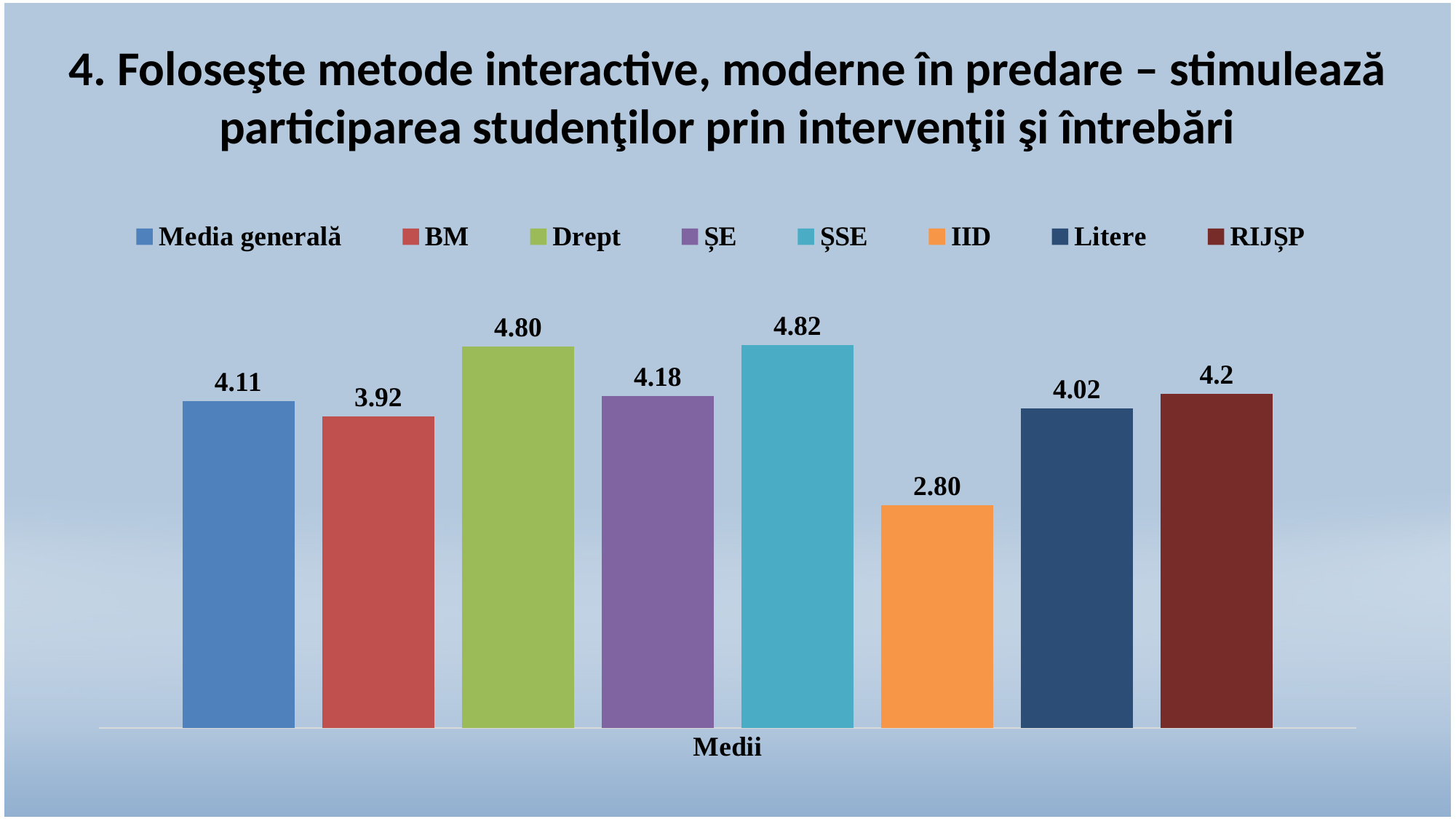
Which series has the highest value? ȘSE Which series has the lowest value? IID How many series does the legend list? 8 Which is larger, the value for ȘE or the value for BM? ȘE What is the value for Media generală? 4.11 What is the label shown on the x axis below the bars? Medii What is the value for RIJȘP? 4.2 What kind of chart is shown on the slide? bar chart What is the difference between the values for Drept and IID? 2.00 What is the difference between the values for ȘSE and BM? 0.90 What is the value for IID? 2.80 What is the value for Drept? 4.80